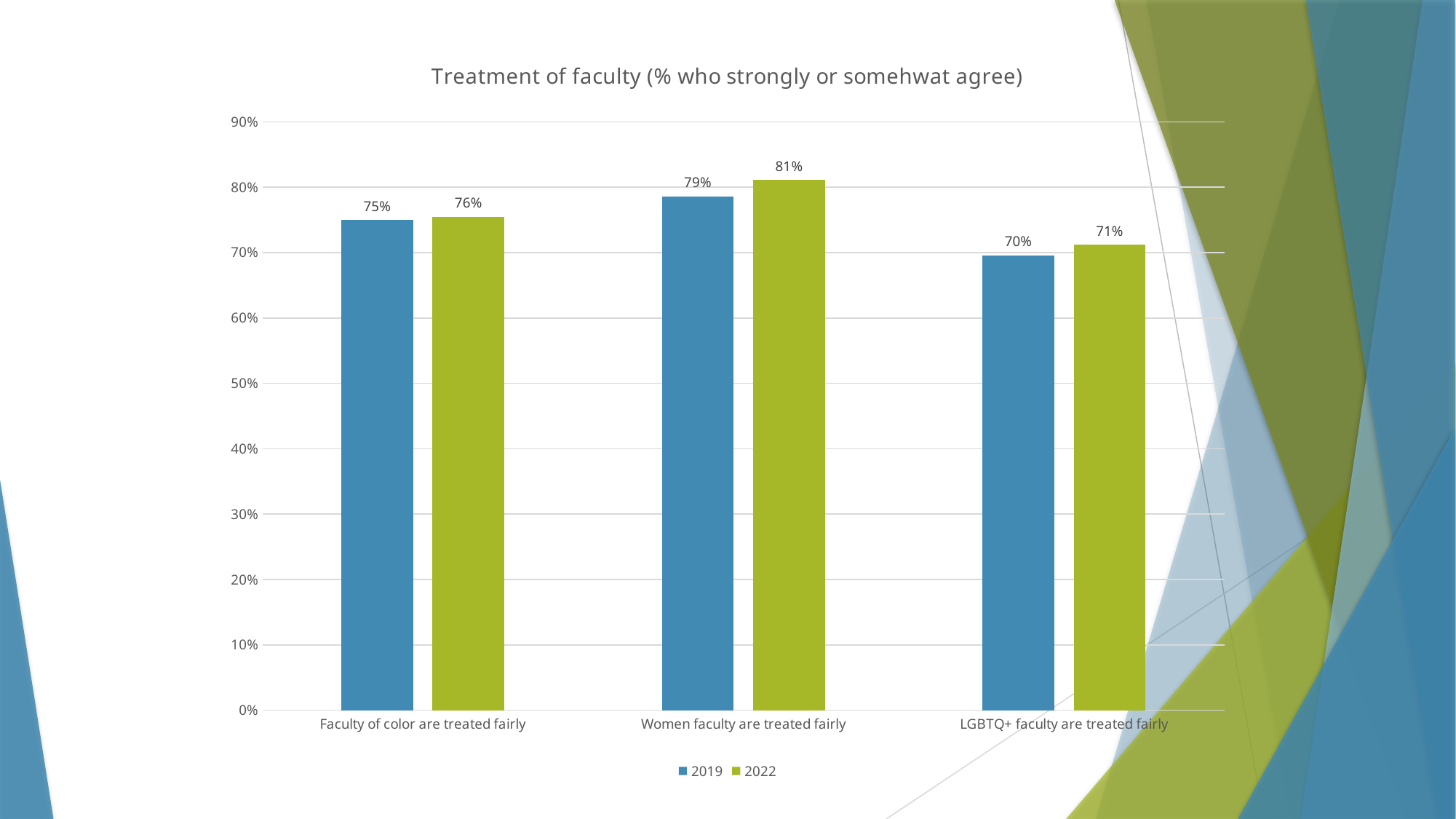
What is the title of the chart? Treatment of faculty (% who strongly or somehwat agree) What is the 2019 value for "Faculty of color are treated fairly"? 75% Which is larger: the 2019 value for "Women faculty are treated fairly" or the 2019 value for "LGBTQ+ faculty are treated fairly"? Women faculty are treated fairly How many categories are shown on the x axis? 3 What kind of chart is shown on the slide? Bar chart What is the difference between the 2022 and 2019 values for "Women faculty are treated fairly"? 2% What is the 2022 value for "LGBTQ+ faculty are treated fairly"? 71% How many series does the legend list? 2 What is the 2022 value for "Women faculty are treated fairly"? 81% Which category has the highest 2022 value? Women faculty are treated fairly Which category has the lowest 2019 value? LGBTQ+ faculty are treated fairly What is the 2019 value for "LGBTQ+ faculty are treated fairly"? 70%